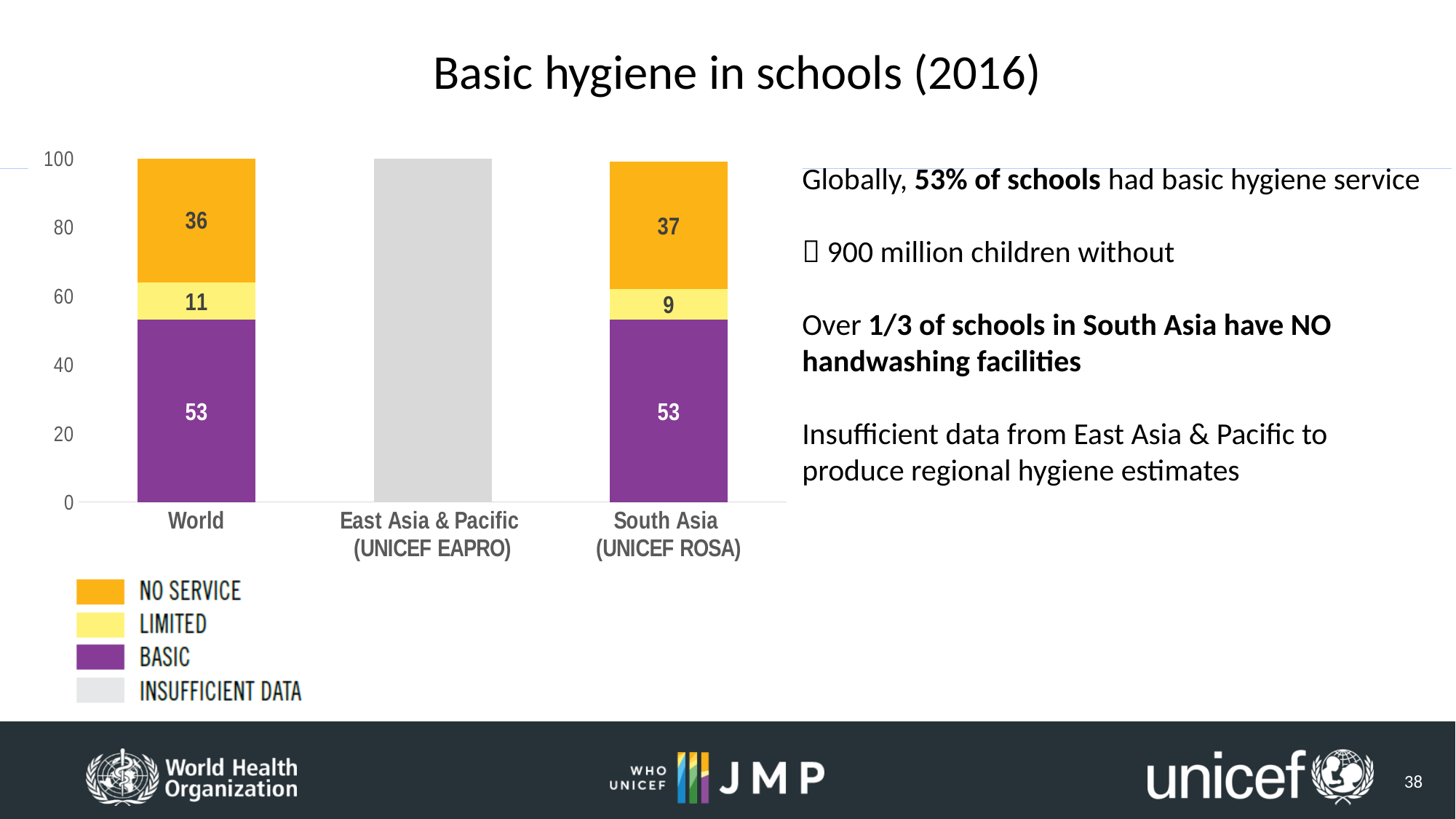
What is the value for Basic in the World bar? 53 What colour represents Basic in the legend? Purple Which category is shown entirely as Insufficient Data? East Asia & Pacific (UNICEF EAPRO) What is the value for No Service in the South Asia (UNICEF ROSA) bar? 37 What is the value for Limited in the World bar? 11 What is the difference between the No Service values for South Asia (UNICEF ROSA) and World? 1 What kind of chart is shown on the slide? Stacked bar chart How many categories are shown on the x axis? 3 How many entries does the legend list? 4 Which has a larger Limited value, World or South Asia (UNICEF ROSA)? World What is the total of the World stacked bar (No Service + Limited + Basic)? 100 What is the value for Limited in the South Asia (UNICEF ROSA) bar? 9